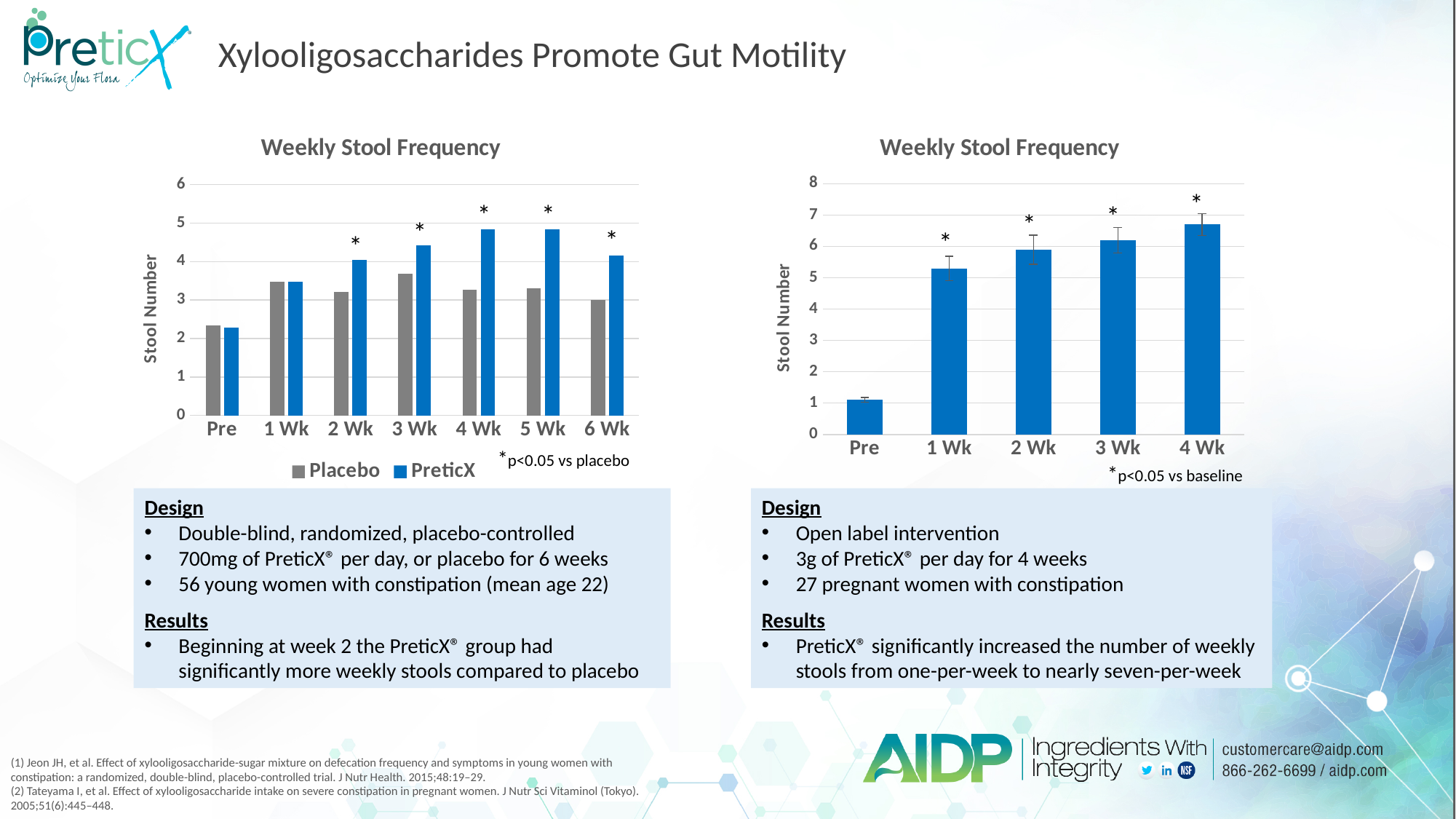
On the right chart, which category has the lowest value? Pre On the left chart, how many series does the legend list? 2 On the right chart, how many categories are shown on the x axis? 5 What kind of chart is the left chart? bar chart On the left chart, is the PreticX value at 2 Wk greater or less than 3? greater On the right chart, is the value for 1 Wk greater or less than 4? greater On the left chart, at 4 Wk, which is larger, Placebo or PreticX? PreticX On the left chart, is the Placebo value at 6 Wk greater or less than 4? less On the left chart, how many categories are shown on the x axis? 7 On the left chart, at which category is the PreticX value lowest? Pre On the right chart, which category has the highest value? 4 Wk On the right chart, do the values rise or fall from Pre to 4 Wk? rise